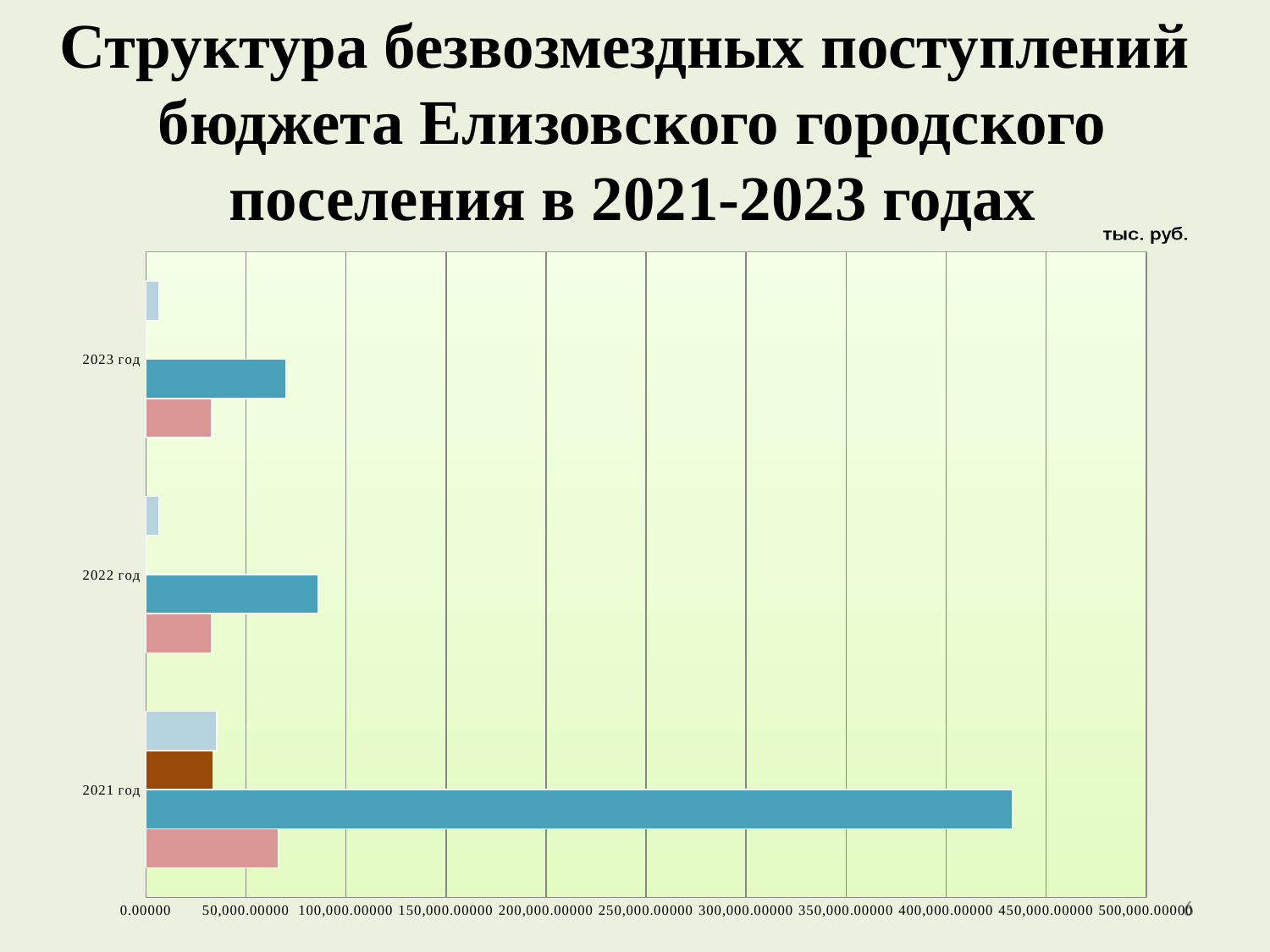
Is the value of the pink bar for 2022 год greater or less than 50,000.00000? less How many year categories are shown on the vertical axis of the chart? 3 Is the value of the pink bar for 2021 год greater or less than 50,000.00000? greater Is the value of the teal bar for 2023 год greater or less than 50,000.00000? greater Which is larger: the pink bar for 2021 год or the pink bar for 2023 год? 2021 год What kind of chart is shown on the slide? bar chart Which year has the longest teal bar? 2021 год Which is larger: the teal bar for 2021 год or the teal bar for 2022 год? 2021 год What unit label is shown above the top right of the chart? тыс. руб. How many bars are plotted for 2021 год? 4